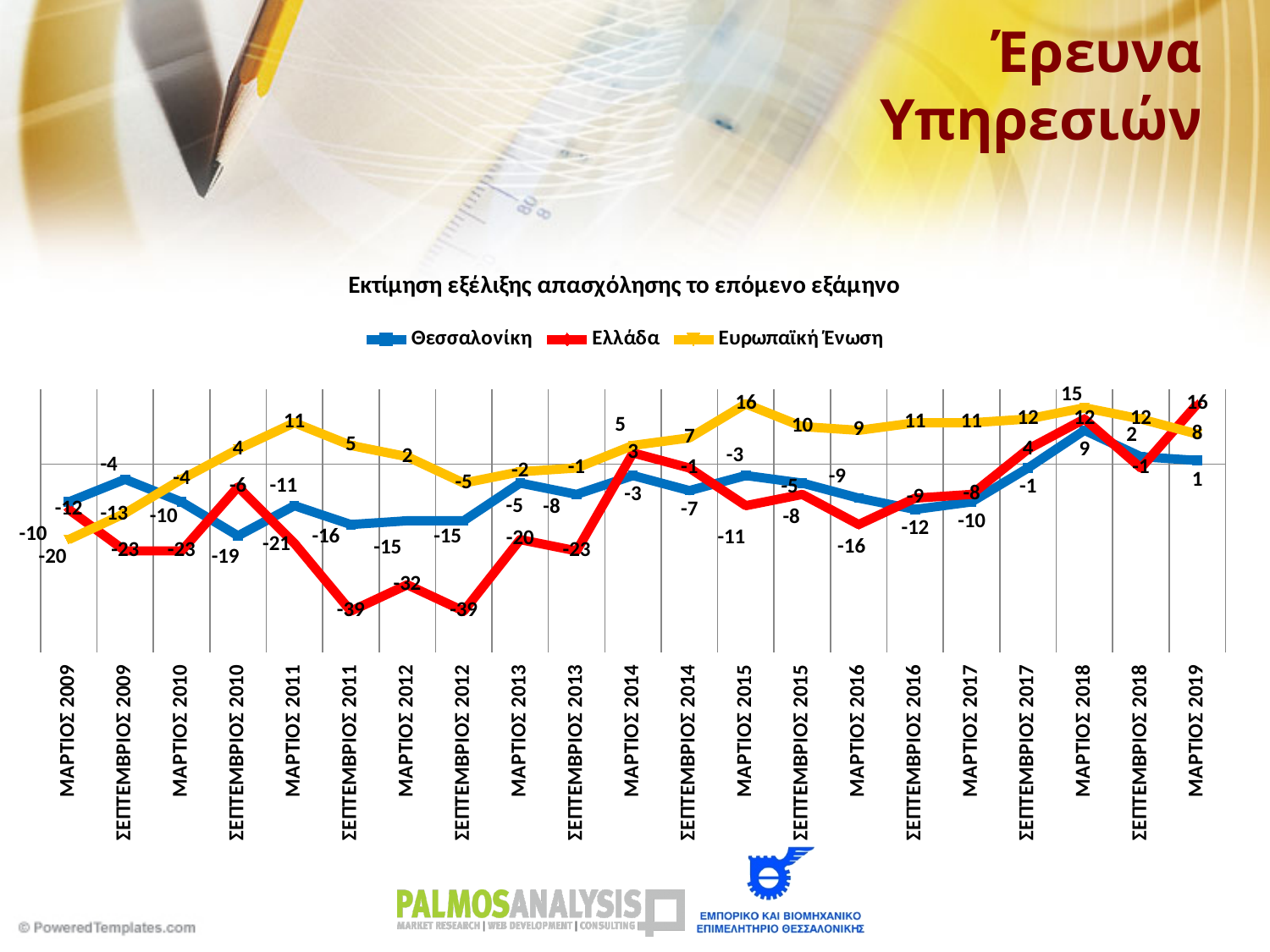
In which period does the Θεσσαλονίκη series reach its highest value? ΜΑΡΤΙΟΣ 2018 What is the lowest value reached by the Ελλάδα series? -39 What is the difference between the Ευρωπαϊκή Ένωση and Ελλάδα values in ΜΑΡΤΙΟΣ 2018? 3 What is the value for Ελλάδα in ΜΑΡΤΙΟΣ 2019? 16 What is the value for Ευρωπαϊκή Ένωση in ΜΑΡΤΙΟΣ 2015? 16 What is the value for Θεσσαλονίκη in ΜΑΡΤΙΟΣ 2018? 9 What kind of chart is shown on the slide? line chart What is the title of the chart? Εκτίμηση εξέλιξης απασχόλησης το επόμενο εξάμηνο How many series does the legend list? 3 How many time points are plotted along the x axis? 21 In ΜΑΡΤΙΟΣ 2019, which is larger: the value for Ελλάδα or for Ευρωπαϊκή Ένωση? Ελλάδα What is the value for Θεσσαλονίκη in ΣΕΠΤΕΜΒΡΙΟΣ 2010? -19